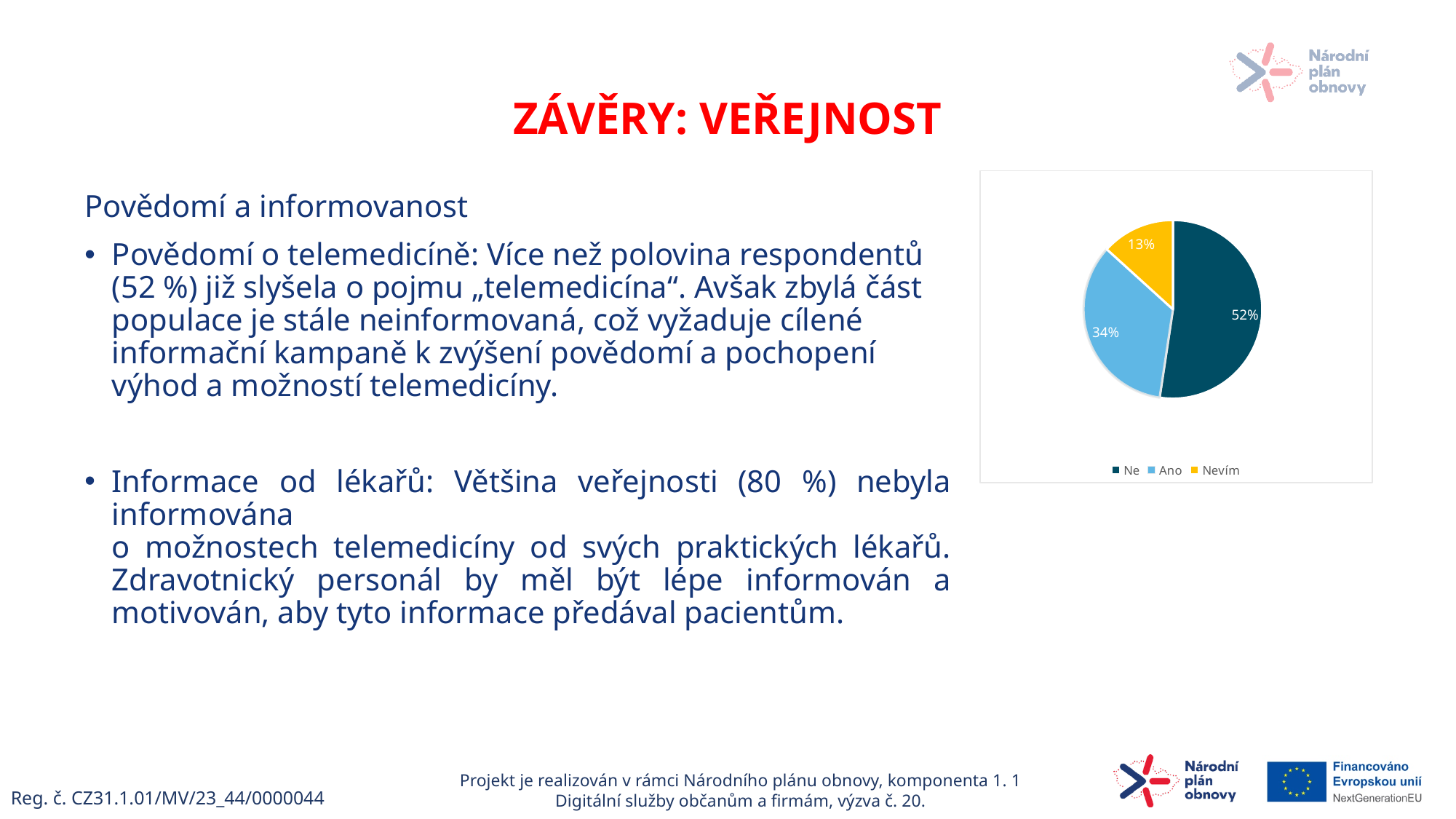
How many slices does the pie chart have? 3 What colour is the "Nevím" slice in the pie chart? yellow Which category has the largest slice of the pie? Ne What is the difference in percentage points between the "Ano" and "Nevím" slices? 21 What share of the pie does the "Ne" slice represent? 52% What kind of chart is shown on the slide? pie chart What share of the pie does the "Ano" slice represent? 34% Which slice is larger, "Ano" or "Nevím"? Ano Which category has the smallest slice of the pie? Nevím How many entries does the chart legend list? 3 What is the difference in percentage points between the "Ne" and "Ano" slices? 18 What share of the pie does the "Nevím" slice represent? 13%